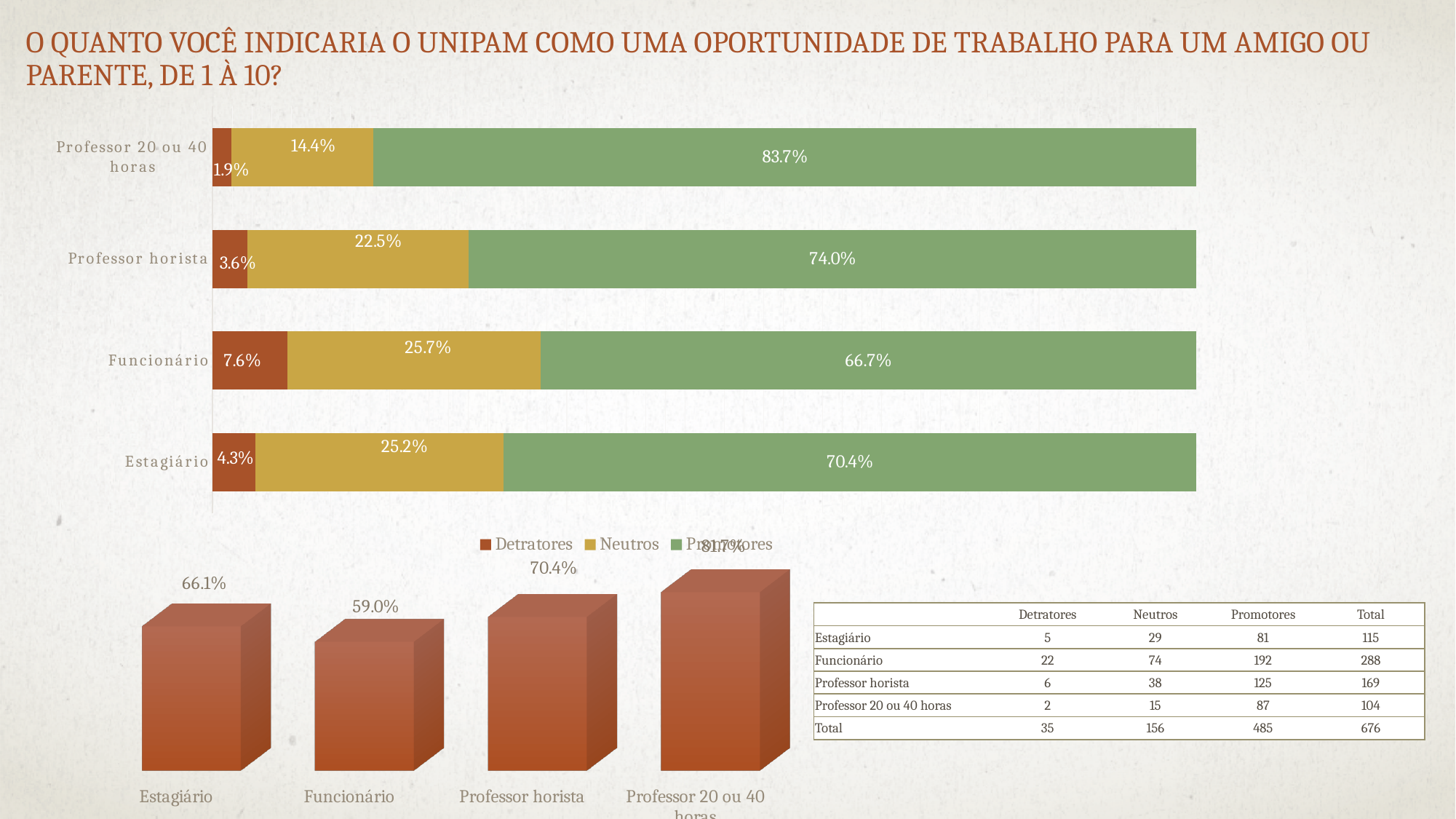
In the top stacked bar chart, which is larger: the Neutros value for Professor horista or for Estagiário? Estagiário How many series does the legend of the top stacked bar chart list? 3 In the top stacked bar chart, what is the Neutros value for Funcionário? 25.7% In the top stacked bar chart, what is the Detratores value for Estagiário? 4.3% In the bottom bar chart, which category has the lowest value? Funcionário In the top stacked bar chart, what is the difference between the Promotores values for Professor horista and Funcionário? 7.3% In the top stacked bar chart, which category has the highest Promotores share? Professor 20 ou 40 horas In the top stacked bar chart, which category has the lowest Detratores share? Professor 20 ou 40 horas In the bottom bar chart, what is the value for Funcionário? 59.0% How many categories are shown in the top stacked bar chart? 4 What kind of chart is the top chart on the slide? Stacked bar chart In the top stacked bar chart, what is the Promotores value for Professor 20 ou 40 horas? 83.7%